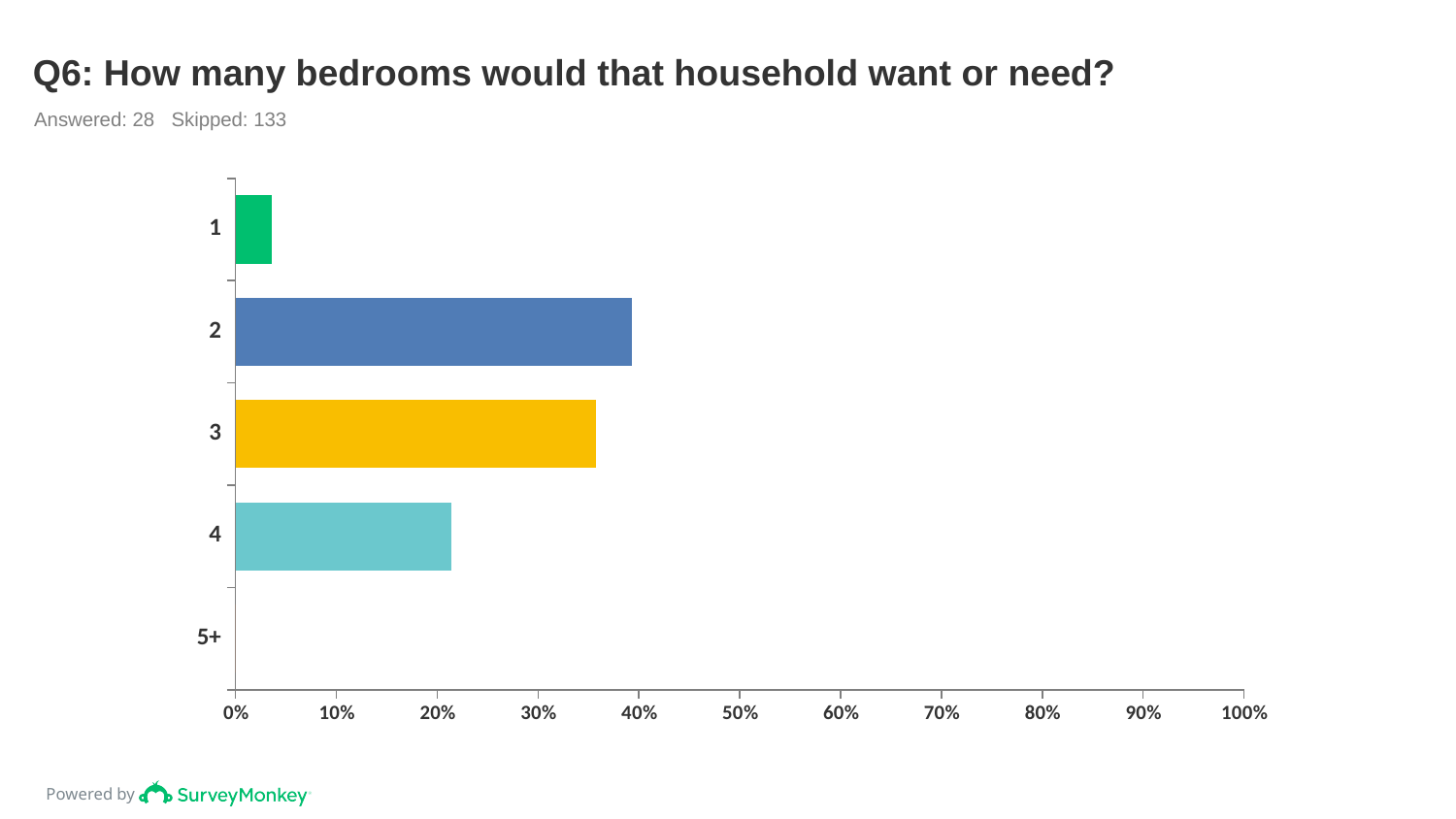
Which bedroom category has the highest share of responses? 2 How many respondents answered this question according to the slide? 28 What is the title of the chart? Q6: How many bedrooms would that household want or need? Is the value for 1 bedroom greater or less than 10%? less Is the value for 3 bedrooms greater or less than 50%? less How many bedroom categories are shown on the chart? 5 What kind of chart is shown on the slide? bar chart Which has a larger share of responses, 2 bedrooms or 3 bedrooms? 2 Is the value for 2 bedrooms greater or less than 30%? greater Which has a larger share of responses, 3 bedrooms or 4 bedrooms? 3 Which bedroom category has the lowest share of responses? 5+